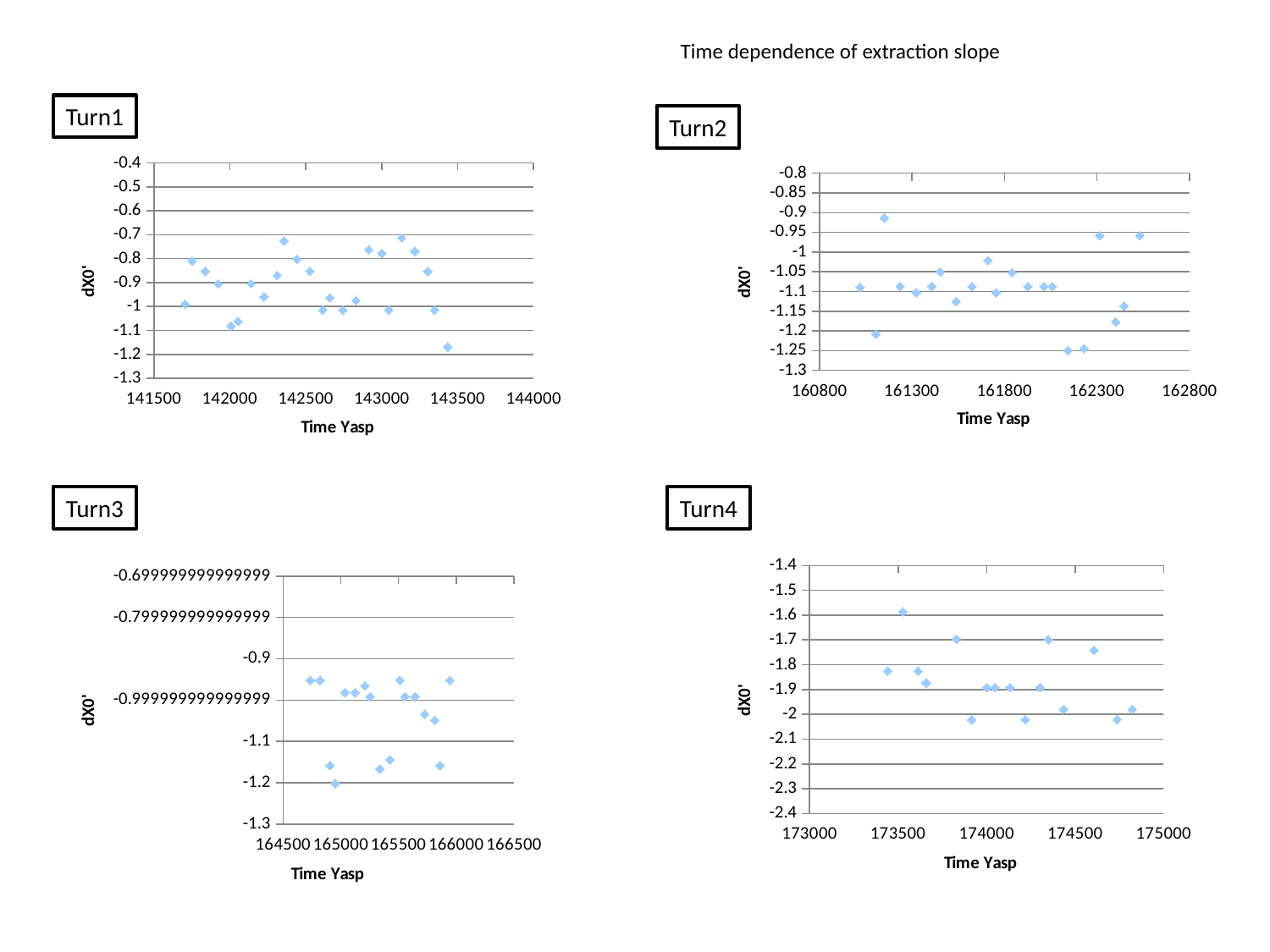
In the Turn1 chart, is the highest plotted point (near Time Yasp 143100) greater or less than -0.8? greater In the Turn2 chart, are the lowest plotted points (near Time Yasp 162200) greater or less than -1.2? less In the Turn4 chart, are the lowest plotted points greater or less than -1.9? less What is the x-axis title of the Turn2 chart? Time Yasp What kind of chart is the Turn4 chart? scatter chart What is the y-axis title of the Turn4 chart? dX0' What kind of chart is the Turn1 chart? scatter chart